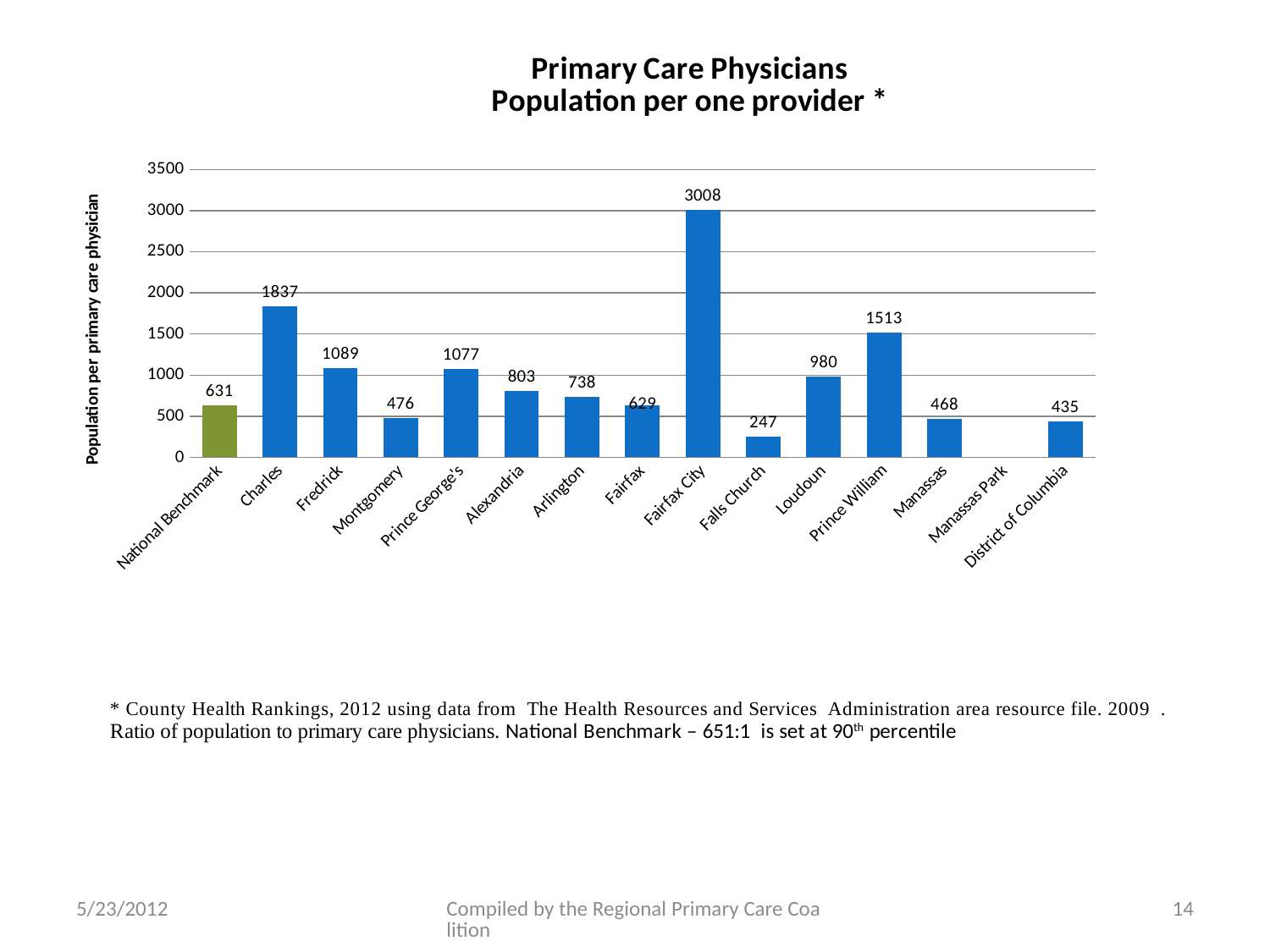
Which category has the highest value? Fairfax City Which is larger, the value for Loudoun or the value for Alexandria? Loudoun What is the difference between the values for Fairfax City and Prince William? 1495 Is the value for Arlington greater or less than 500? greater How many category labels are shown on the x axis? 15 What is the title of the y axis? Population per primary care physician Which category has the shortest bar? Falls Church What kind of chart is shown on the slide? bar chart What is the difference between the values for Charles and the National Benchmark? 1206 What is the value for Fairfax City? 3008 What is the value for the National Benchmark bar? 631 What is the value for Prince William? 1513